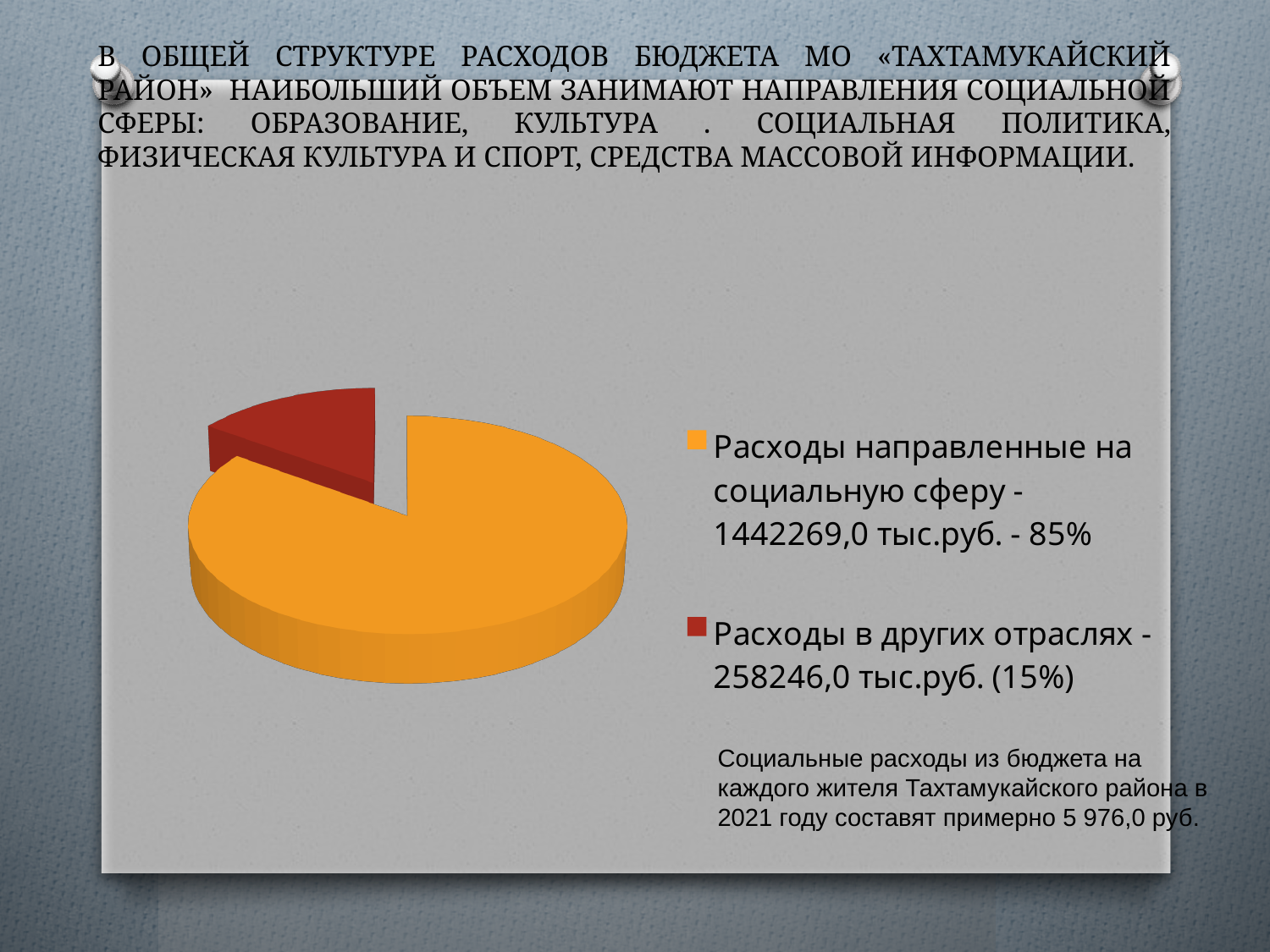
What amount is given for "Расходы направленные на социальную сферу"? 1442269,0 тыс.руб. Which slice of the pie chart is the largest? Расходы направленные на социальную сферу What colour is the slice for "Расходы в других отраслях"? red How many slices does the pie chart have? 2 How many entries does the legend of the pie chart list? 2 What share of the pie does "Расходы направленные на социальную сферу" take? 85% What amount is given for "Расходы в других отраслях"? 258246,0 тыс.руб. Which is larger: "Расходы направленные на социальную сферу" or "Расходы в других отраслях"? Расходы направленные на социальную сферу What share of the pie does "Расходы в других отраслях" take? 15% What kind of chart is shown on the slide? pie chart Which slice of the pie chart is the smallest? Расходы в других отраслях What is the difference in тыс.руб. between "Расходы направленные на социальную сферу" and "Расходы в других отраслях"? 1184023,0 тыс.руб.